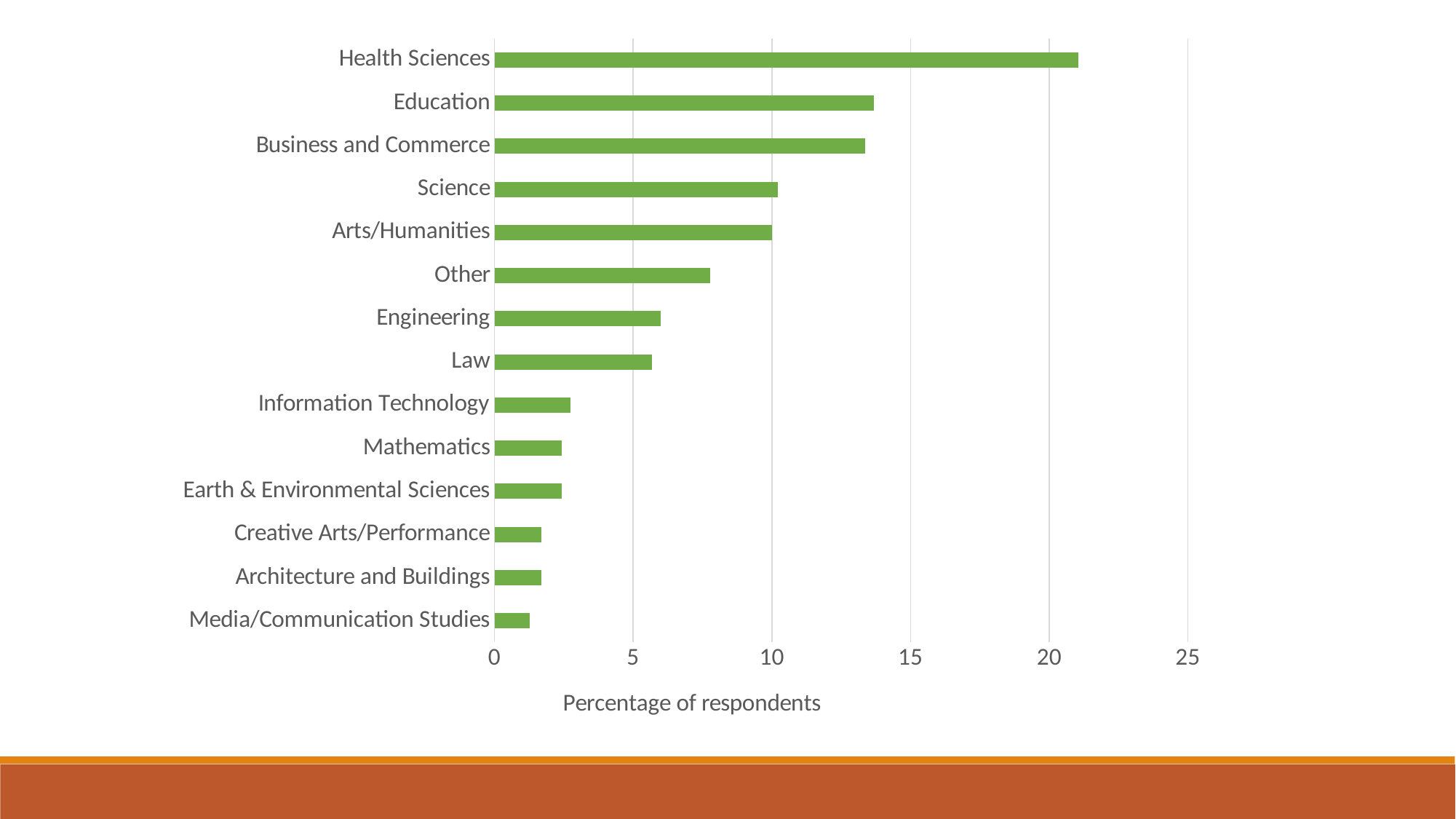
Is the value for Engineering greater or less than 5? greater Which has a higher percentage of respondents, Science or Other? Science Is the value for Health Sciences greater or less than 20? greater Which has a higher percentage of respondents, Law or Mathematics? Law Is the value for Information Technology greater or less than 5? less Which category has the lowest percentage of respondents? Media/Communication Studies Which category has the highest percentage of respondents? Health Sciences How many categories are shown in the chart? 14 What type of chart is shown on the slide? Bar chart